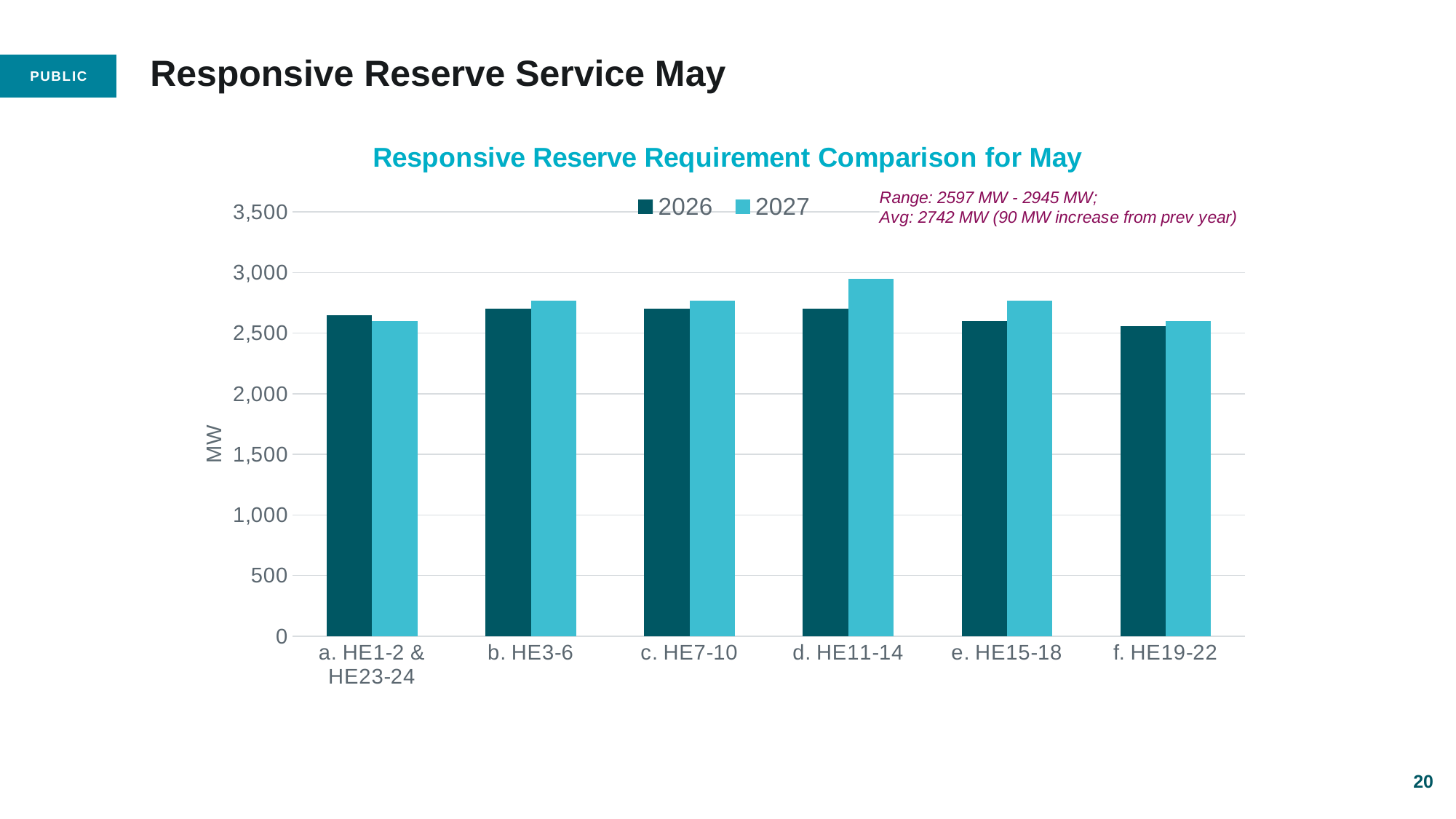
What type of chart is shown on the slide? Bar chart What label is shown on the y axis of the chart? MW How many hour-ending categories are shown on the x axis? 6 How many series does the legend list? 2 For d. HE11-14, which series has the larger value, 2026 or 2027? 2027 What is the title of the chart? Responsive Reserve Requirement Comparison for May Is the 2027 value for d. HE11-14 greater or less than 3,000? less Is the 2026 value for e. HE15-18 greater or less than 3,000? less Which category has the highest 2027 value? d. HE11-14 Which is larger: the 2027 value for d. HE11-14 or the 2027 value for f. HE19-22? d. HE11-14 For a. HE1-2 & HE23-24, which series has the larger value, 2026 or 2027? 2026 Is the 2027 value for b. HE3-6 greater or less than 2,500? greater